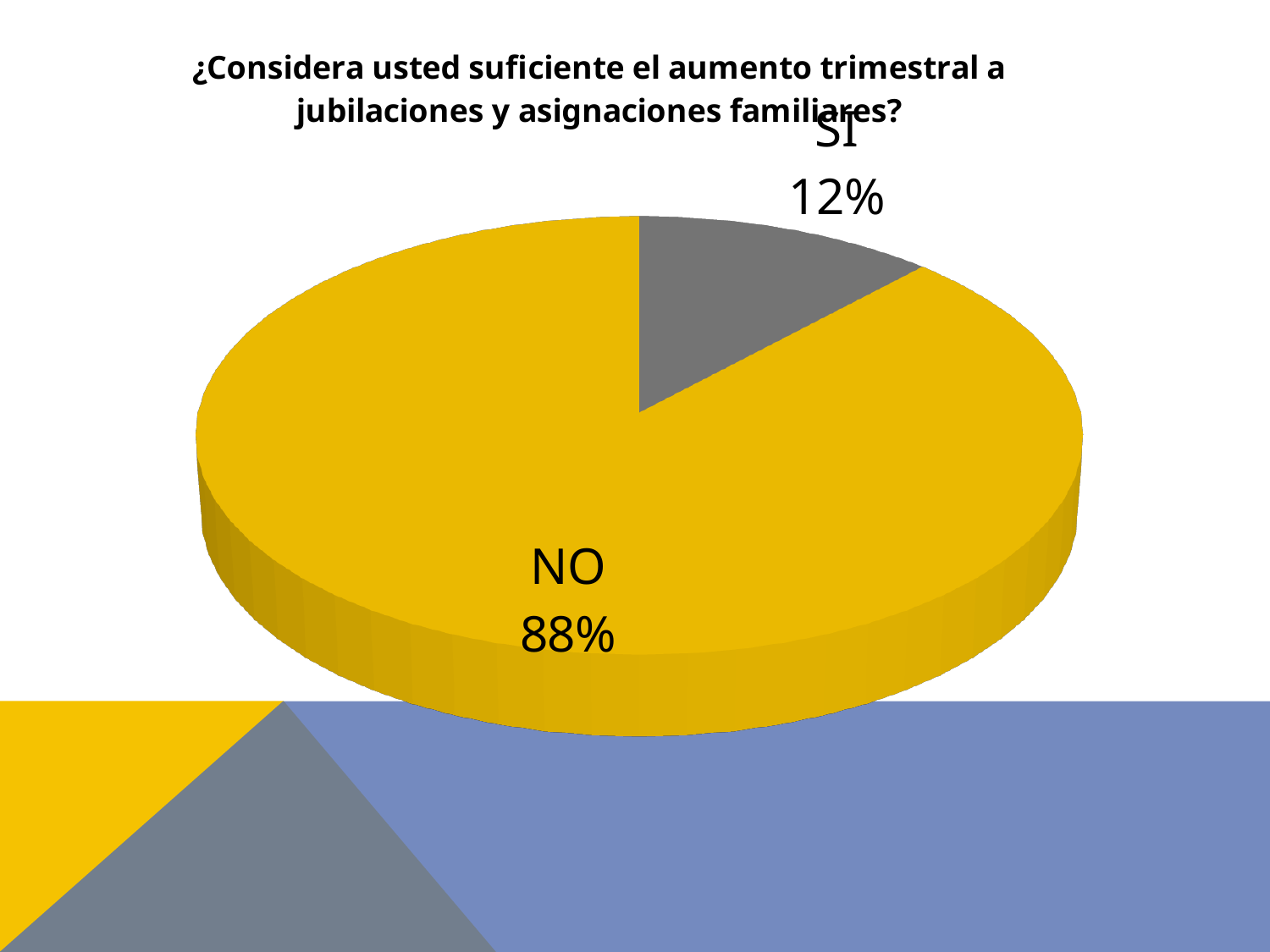
How many slices does the pie chart have? 2 What kind of chart is shown on the slide? pie chart Which response has the smallest share of the pie? SI What is the difference in percentage points between the NO and SI responses? 76 Which response has the largest share of the pie? NO What percentage of respondents answered SI? 12% What is the title of the chart? ¿Considera usted suficiente el aumento trimestral a jubilaciones y asignaciones familiares? What colour is the NO slice of the pie? yellow What percentage of respondents answered NO? 88% Is the share for SI greater or less than 50%? less Which response is larger, SI or NO? NO